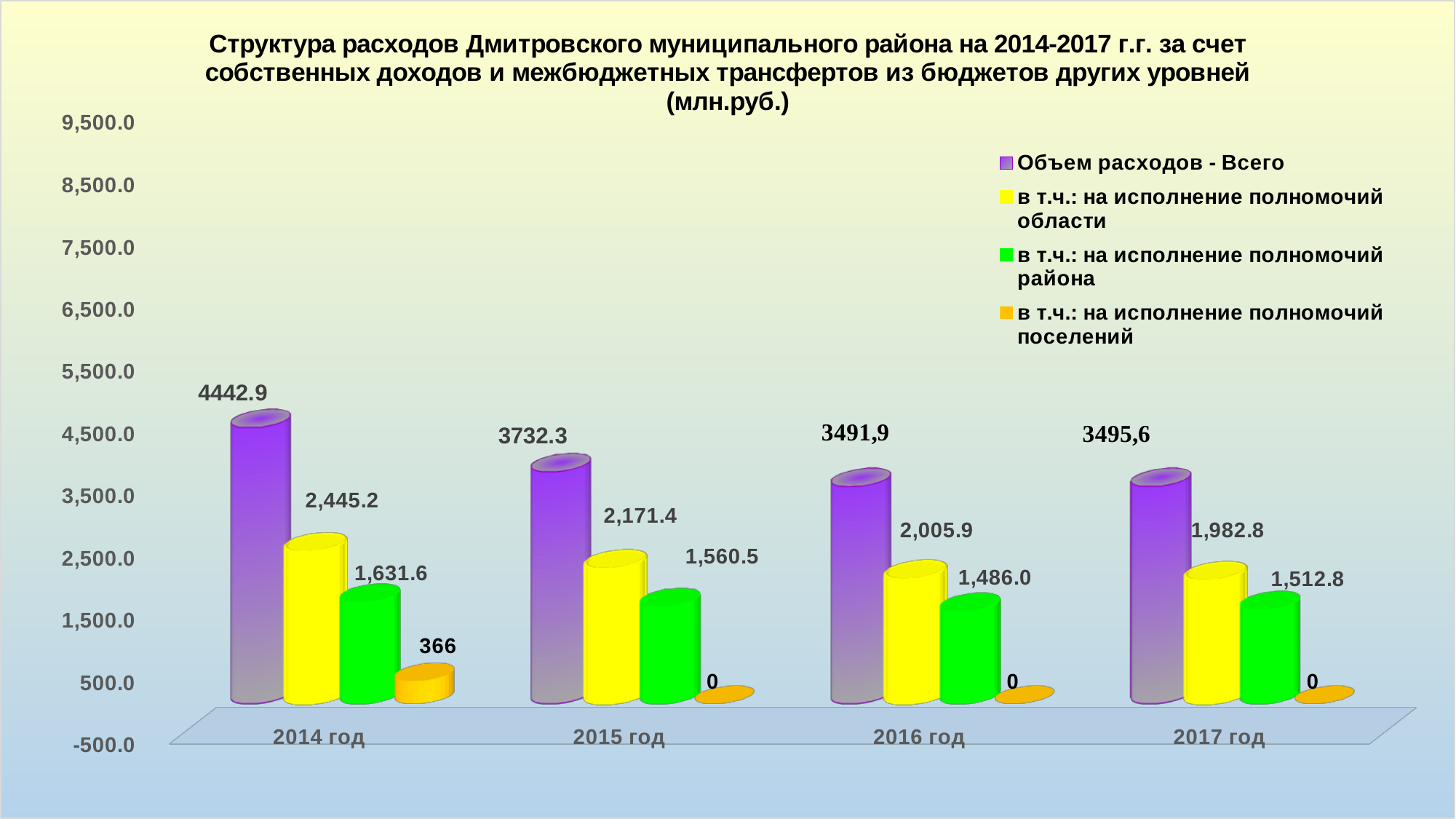
How many series does the legend list? 4 In which year is "в т.ч.: на исполнение полномочий области" the lowest? 2017 год What is the difference between "в т.ч.: на исполнение полномочий области" in 2014 год and 2015 год? 273.8 What is the value for "в т.ч.: на исполнение полномочий области" in 2016 год? 2,005.9 Does "в т.ч.: на исполнение полномочий области" rise or fall from 2014 год to 2017 год? fall What is the difference between "Объем расходов - Всего" in 2014 год and 2015 год? 710.6 What is the value for "в т.ч.: на исполнение полномочий района" in 2017 год? 1,512.8 What is the value of "Объем расходов - Всего" for 2014 год? 4442.9 In which year is "Объем расходов - Всего" the highest? 2014 год How many years are shown on the x axis? 4 Which is larger: "в т.ч.: на исполнение полномочий района" in 2016 год or in 2017 год? 2017 год What is the value for "в т.ч.: на исполнение полномочий поселений" in 2014 год? 366